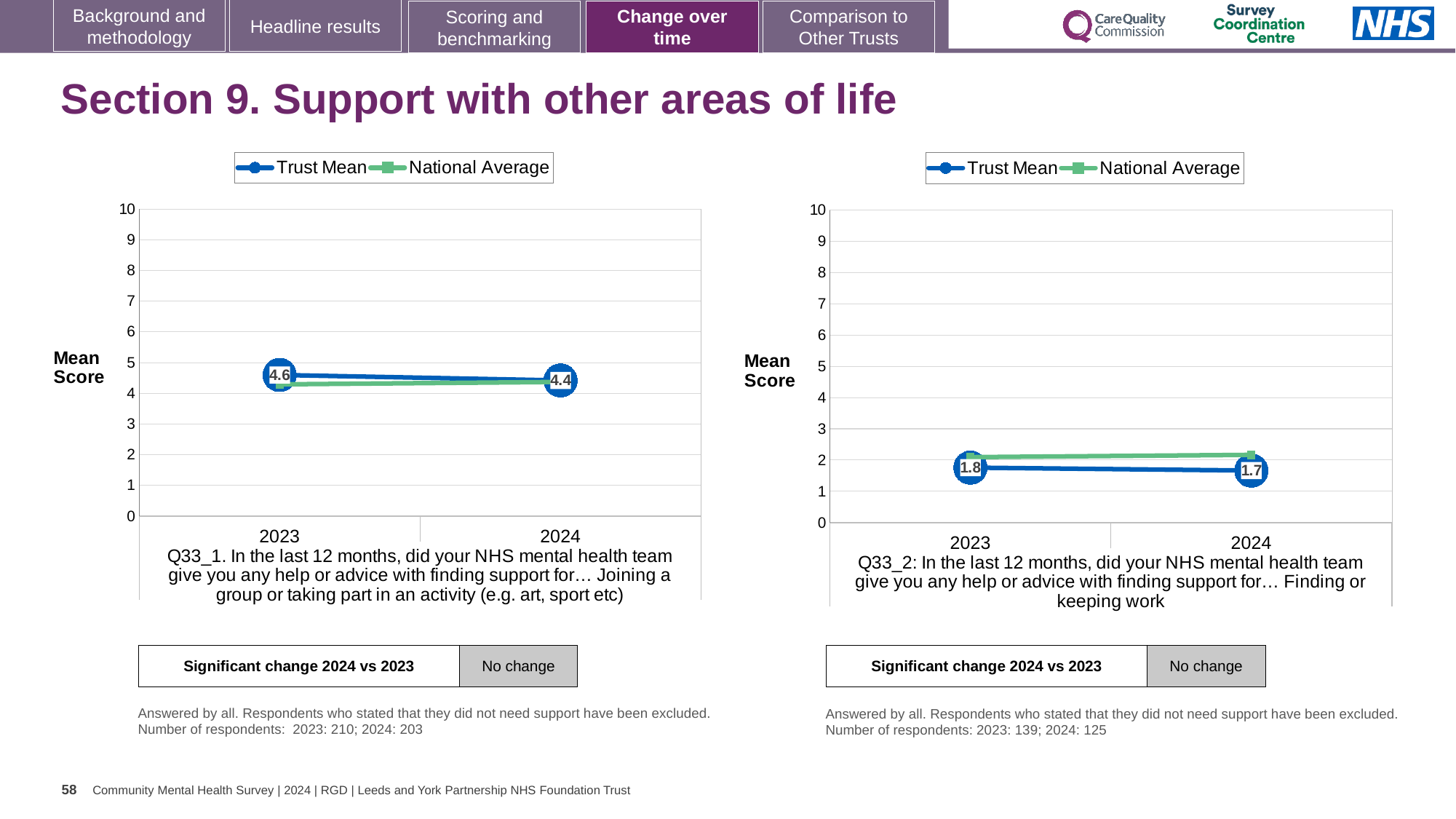
On the Q33_2 chart (right), is the National Average for 2023 greater or less than 3? less On the Q33_1 chart (left), what is the Trust Mean score for 2023? 4.6 On the Q33_1 chart (left), by how much did the Trust Mean change from 2023 to 2024? 0.2 On the Q33_2 chart (right), what is the Trust Mean score for 2024? 1.7 On the Q33_2 chart (right), in 2024 which is larger, the Trust Mean or the National Average? National Average On the Q33_1 chart (left), what is the Trust Mean score for 2024? 4.4 How many series does the legend of the Q33_2 chart (right) list? 2 On the Q33_2 chart (right), what is the difference between the Trust Mean in 2023 and 2024? 0.1 On the Q33_1 chart (left), does the Trust Mean rise or fall from 2023 to 2024? fall On the Q33_1 chart (left), is the National Average for 2024 greater or less than 5? less What kind of chart is the Q33_1 chart (left)? line chart On the Q33_2 chart (right), what is the Trust Mean score for 2023? 1.8